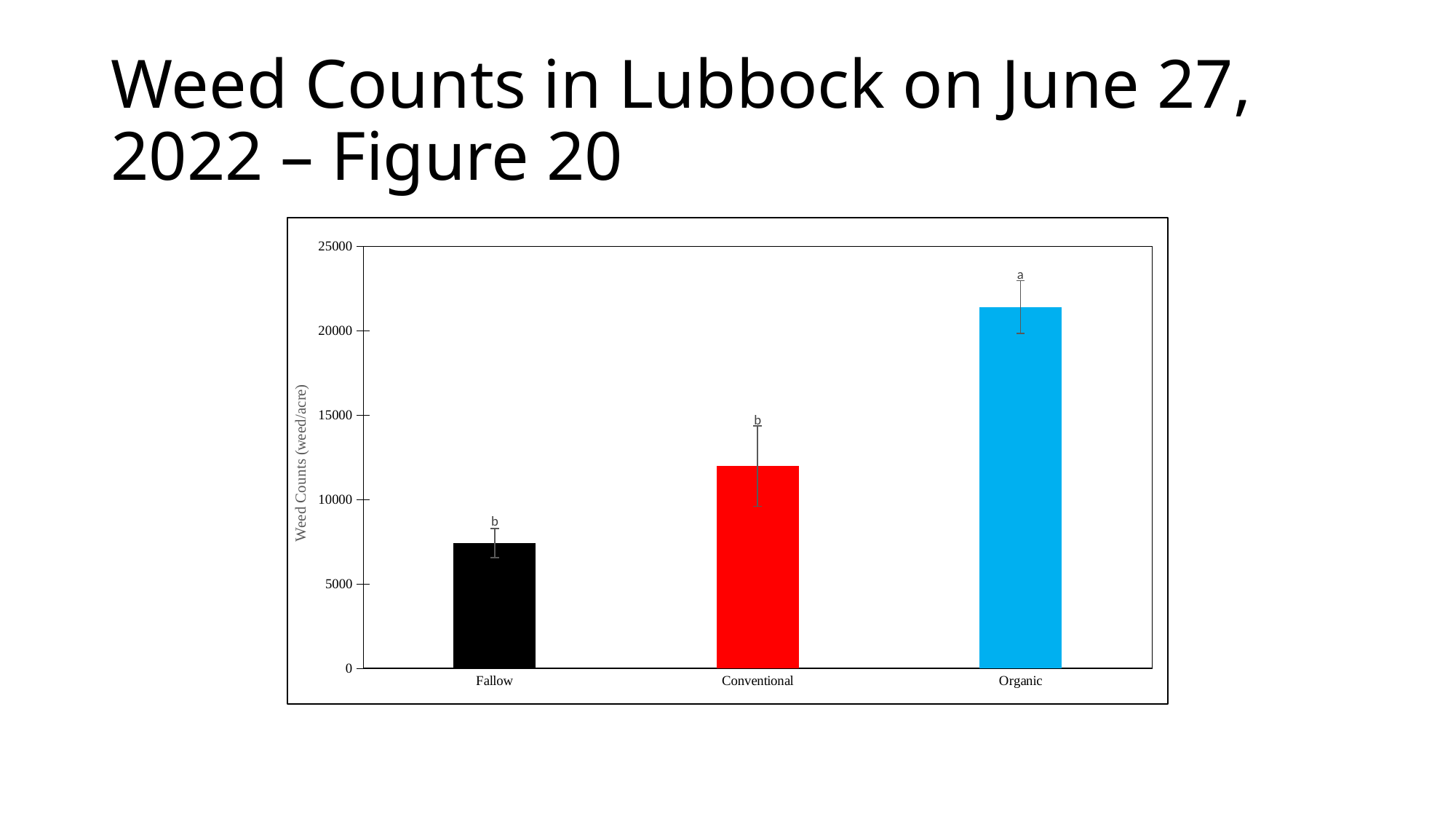
Which has a larger weed count, Conventional or Fallow? Conventional How many categories are plotted on the x axis? 3 Is the value for Fallow greater or less than 10000? less Is the value for Organic greater or less than 20000? greater What colour is the bar for Organic? blue What is the label of the y axis? Weed Counts (weed/acre) Do the weed counts rise or fall moving from Fallow to Organic along the x axis? rise Which category has the lowest weed count? Fallow Is the value for Conventional greater or less than 10000? greater Which category has the highest weed count? Organic Which has a larger weed count, Organic or Conventional? Organic What kind of chart is shown on the slide? bar chart